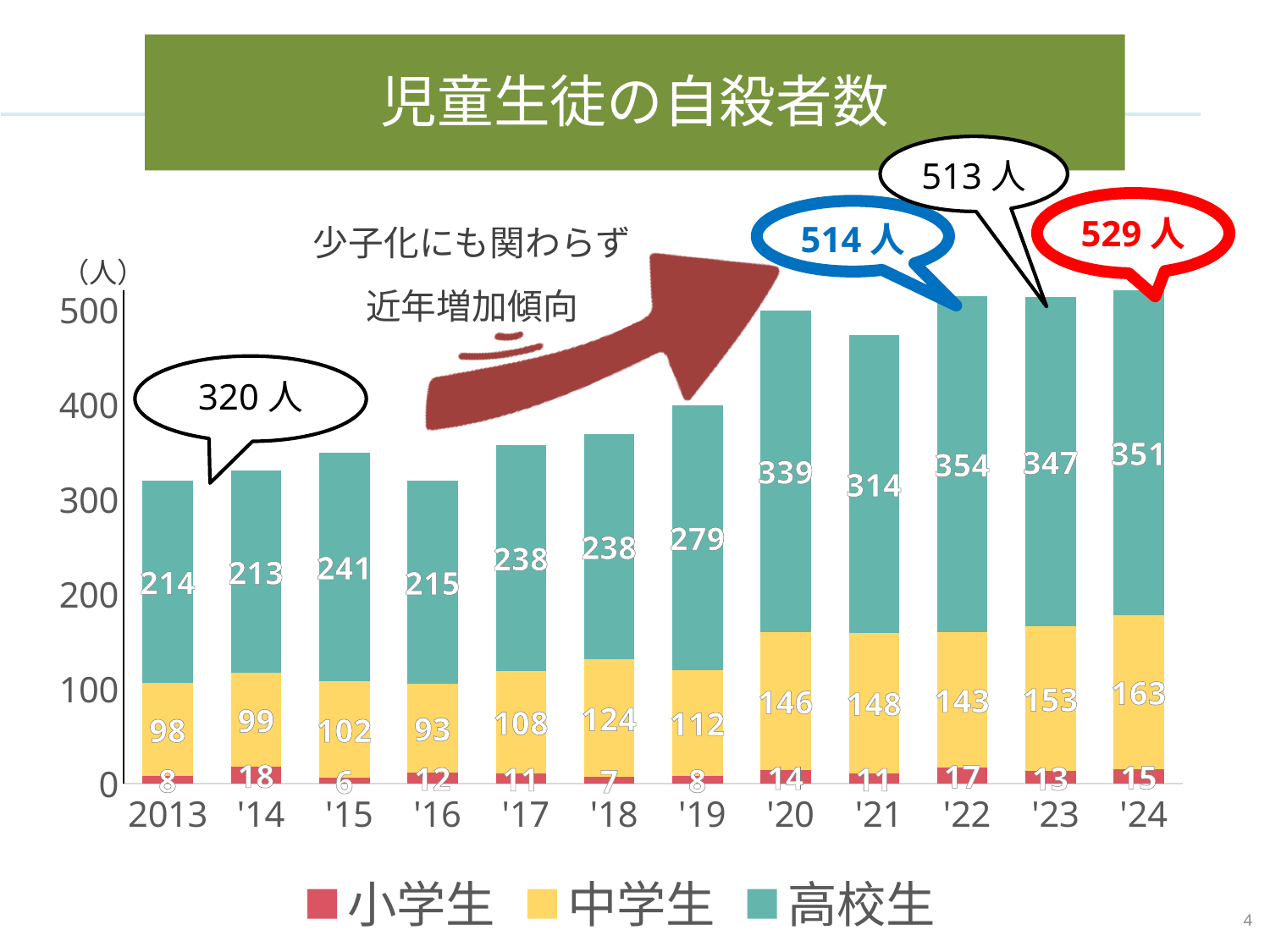
What is the total of the stacked bar for '24? 529 What kind of chart is shown on the slide? Stacked bar chart What is the title of the chart? 児童生徒の自殺者数 Which is larger, the 高校生 value for '20 or for '21? '20 How many series does the legend list? 3 What is the value for 高校生 in '24? 351 What is the value for 小学生 in '22? 17 How many years are shown on the x axis? 12 What is the value for 中学生 in 2013? 98 Which year has the lowest value for 小学生? '15 Which year has the highest value for 高校生? '22 What is the difference between the 中学生 values for '24 and '23? 10